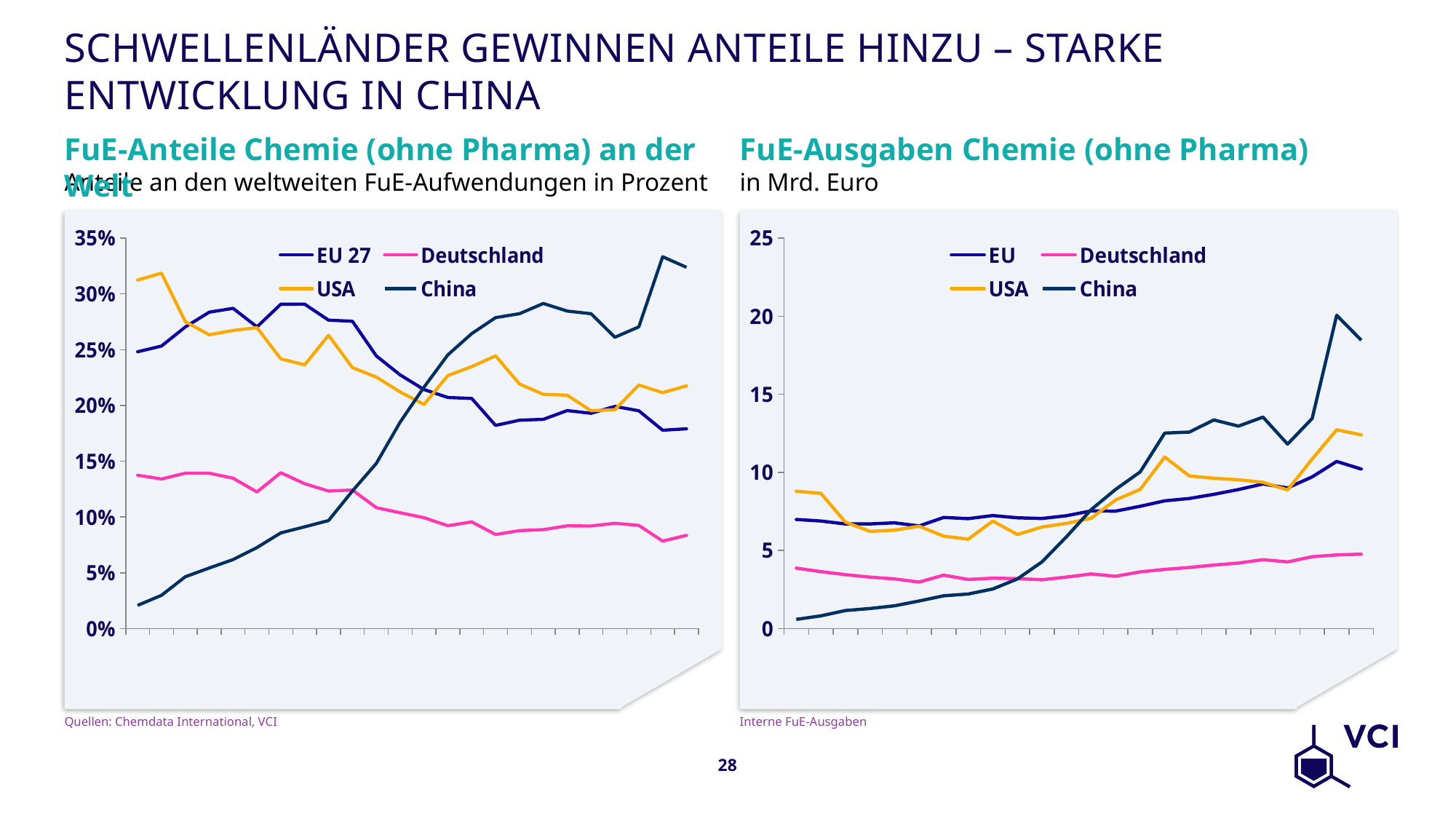
What kind of chart is the left chart, "FuE-Anteile Chemie (ohne Pharma) an der Welt"? line chart In the left chart, "FuE-Anteile Chemie (ohne Pharma) an der Welt", does the Deutschland line rise or fall overall along the x axis? fall In the left chart, "FuE-Anteile Chemie (ohne Pharma) an der Welt", is the final value for China greater or less than 30%? greater In the left chart, "FuE-Anteile Chemie (ohne Pharma) an der Welt", which series has the lowest value at the right end of the x axis? Deutschland In the left chart, "FuE-Anteile Chemie (ohne Pharma) an der Welt", does the China line rise or fall along the x axis? rise In the left chart, "FuE-Anteile Chemie (ohne Pharma) an der Welt", is the final value for Deutschland greater or less than 10%? less In the right chart, "FuE-Ausgaben Chemie (ohne Pharma)", at the right end of the x axis, is the value for EU or for Deutschland larger? EU In the right chart, "FuE-Ausgaben Chemie (ohne Pharma)", which series has the lowest value at the right end of the x axis? Deutschland In the left chart, "FuE-Anteile Chemie (ohne Pharma) an der Welt", which series has the highest value at the right end of the x axis? China What unit is given in the subtitle of the right chart, "FuE-Ausgaben Chemie (ohne Pharma)"? Mrd. Euro In the right chart, "FuE-Ausgaben Chemie (ohne Pharma)", is the final value for China greater or less than 15? greater How many series does the legend of the right chart, "FuE-Ausgaben Chemie (ohne Pharma)", list? 4